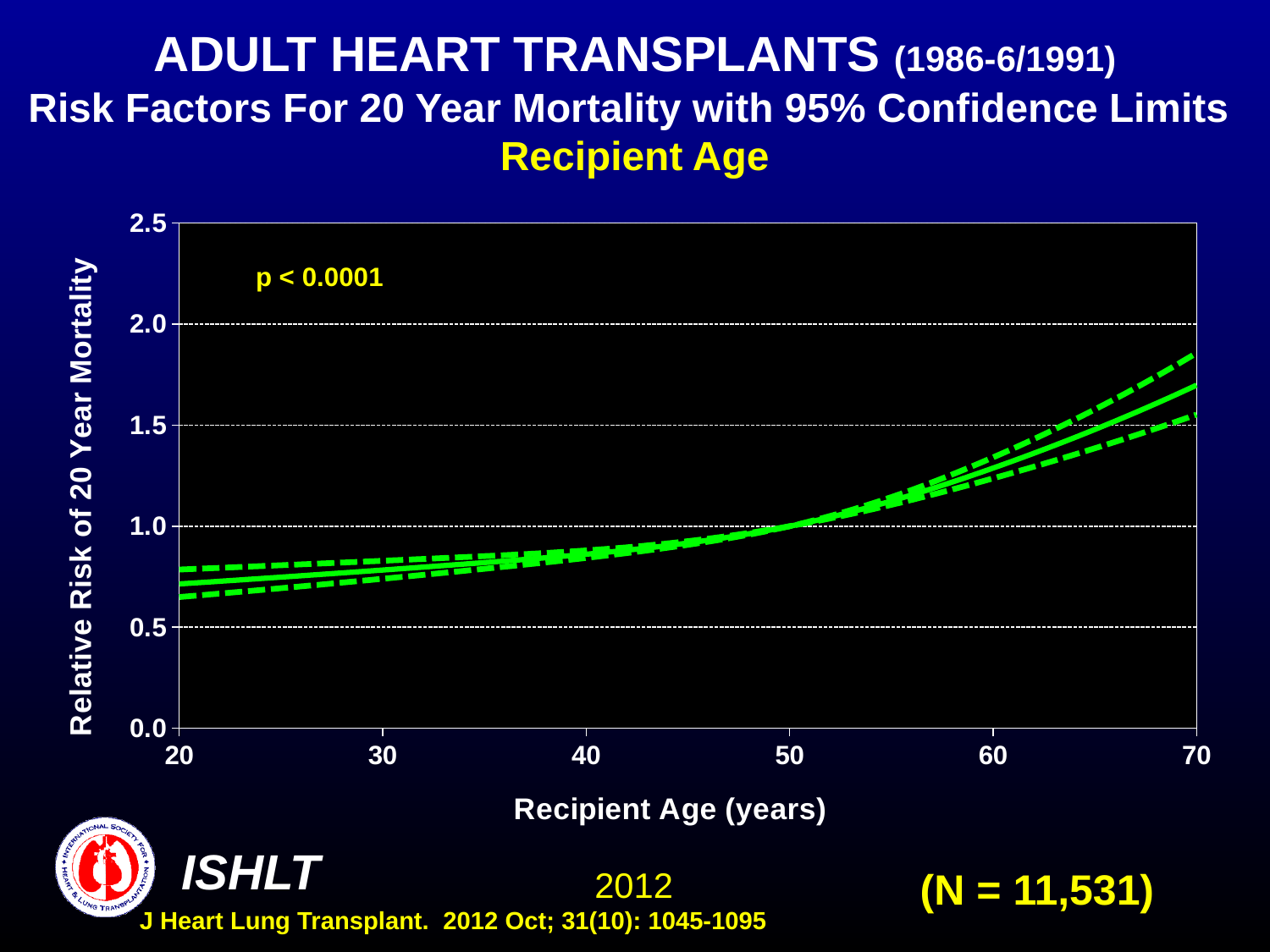
Is the relative risk of 20 year mortality for a recipient aged 70 greater or less than 1.5? greater What p-value is printed on the chart? p < 0.0001 Is the relative risk of 20 year mortality for a recipient aged 20 greater or less than 1.0? less Is the relative risk of 20 year mortality for a recipient aged 30 greater or less than 0.5? greater How many lines are plotted on the chart (the estimate plus its confidence limits)? 3 What kind of chart is shown on the slide? line chart Which recipient age has the higher relative risk of 20 year mortality, 30 or 60? 60 Does the relative risk of 20 year mortality rise or fall as recipient age increases from 20 to 70 years? rise What is the label of the x axis? Recipient Age (years)